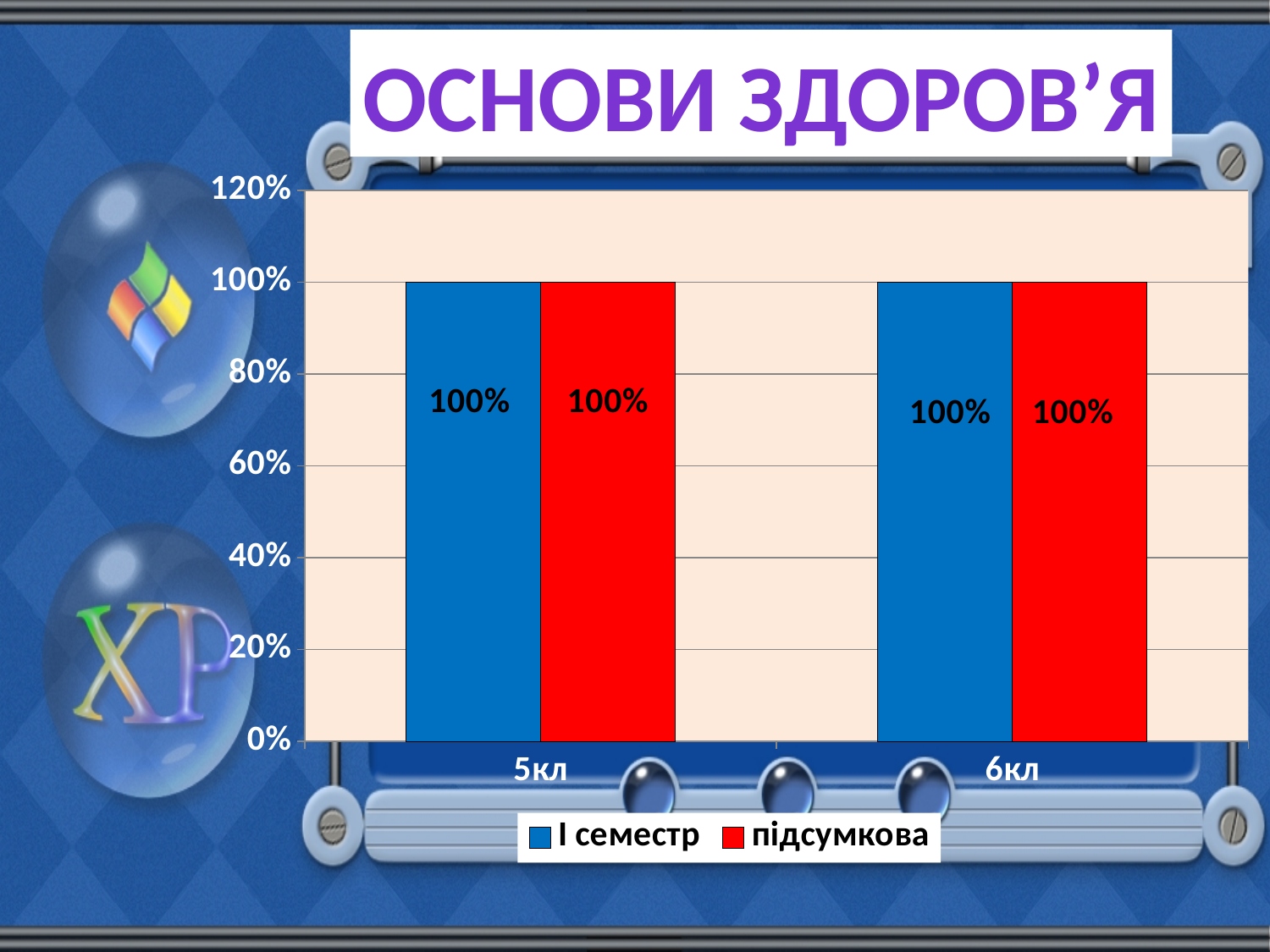
How many categories are shown on the x axis? 2 What is the difference between the І семестр and підсумкова values for 5кл? 0% What is the title of the chart? ОСНОВИ ЗДОРОВ’Я What is the value for І семестр in 6кл? 100% What kind of chart is shown on the slide? bar chart What is the value for підсумкова in 5кл? 100% What is the value for підсумкова in 6кл? 100% How many series does the legend list? 2 What is the difference between the І семестр value for 5кл and the І семестр value for 6кл? 0% Is the value for підсумкова in 6кл greater or less than 80%? greater Which colour represents the підсумкова series in the legend? red What is the value for І семестр in 5кл? 100%